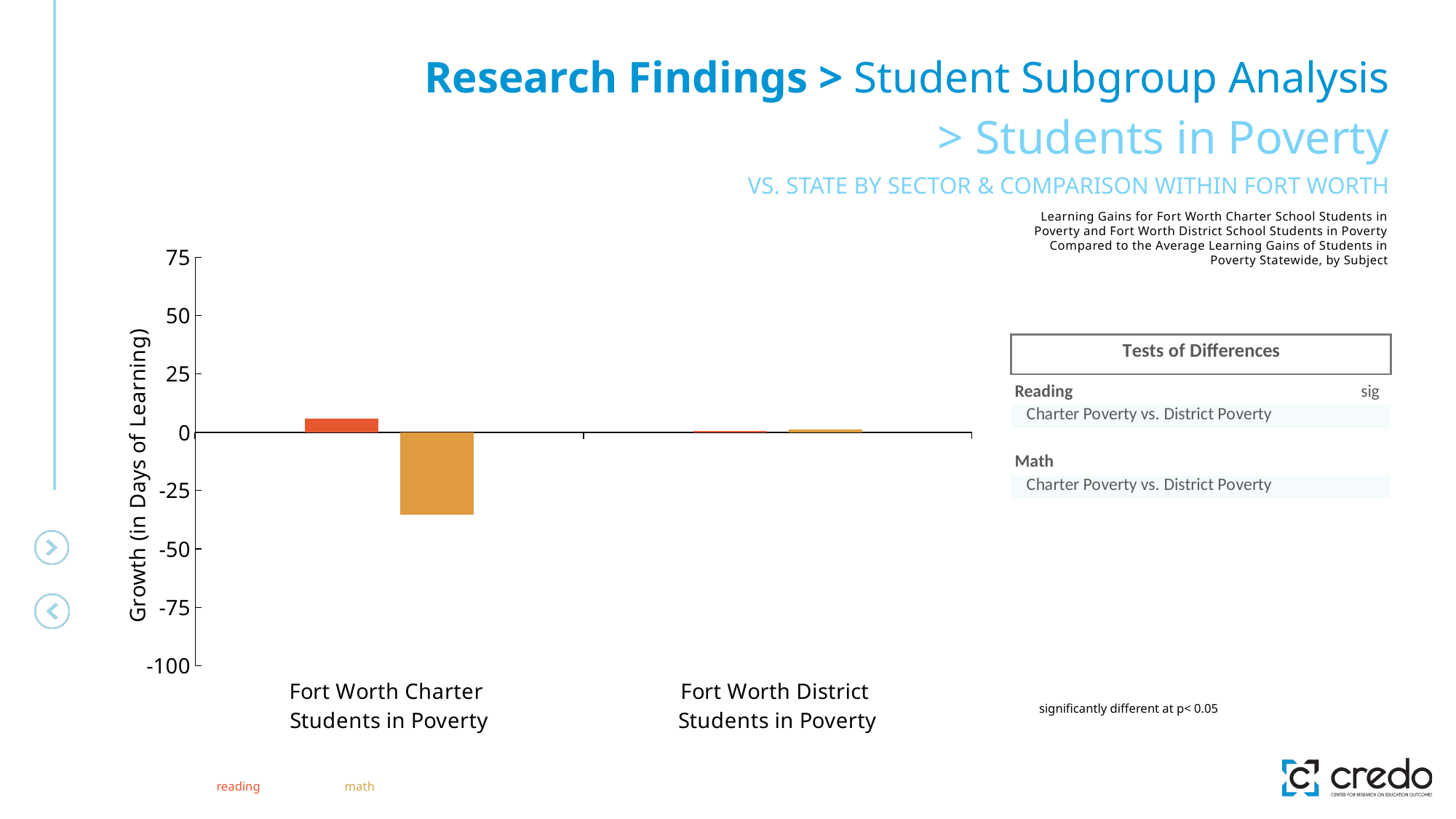
Which bar in the chart has the highest value? reading for Fort Worth Charter Students in Poverty How many categories are shown on the x axis of the chart? 2 Is the reading value for Fort Worth Charter Students in Poverty greater or less than 25? less What is the label of the y axis? Growth (in Days of Learning) Is the reading value for Fort Worth Charter Students in Poverty greater or less than 0? greater What kind of chart is shown on the slide? bar chart For Fort Worth Charter Students in Poverty, which is larger, the reading value or the math value? reading How many series does the chart's legend list? 2 Is the math value for Fort Worth Charter Students in Poverty greater or less than -25? less Which bar in the chart has the lowest value? math for Fort Worth Charter Students in Poverty Which series does the legend list in orange-red? reading